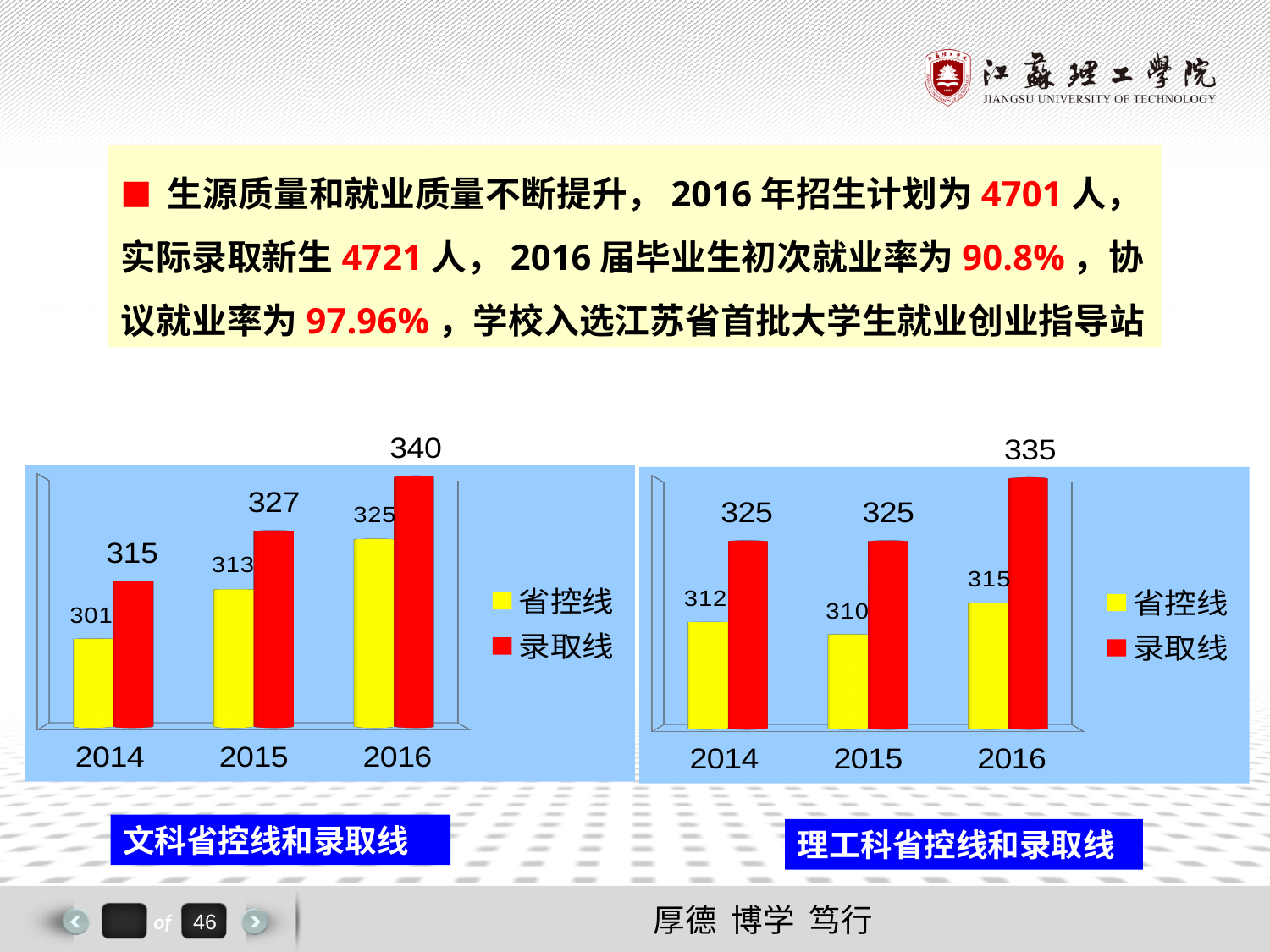
In the 理工科省控线和录取线 chart (right), what is the 省控线 value for 2015? 310 In the 文科省控线和录取线 chart (left), what is the difference between the 录取线 and the 省控线 in 2015? 14 In the 文科省控线和录取线 chart (left), which year has the highest 录取线? 2016 In the 理工科省控线和录取线 chart (right), which year has the lowest 省控线? 2015 In the 理工科省控线和录取线 chart (right), what is the 录取线 value for 2016? 335 In the 理工科省控线和录取线 chart (right), what is the difference between the 录取线 in 2016 and the 录取线 in 2015? 10 In the 文科省控线和录取线 chart (left), which is larger: the 省控线 in 2016 or the 录取线 in 2014? 省控线 in 2016 What kind of chart is the 文科省控线和录取线 chart (left)? Bar chart In the 文科省控线和录取线 chart (left), does the 省控线 rise or fall from 2014 to 2016? Rise In the 文科省控线和录取线 chart (left), what is the 省控线 value for 2014? 301 In the 文科省控线和录取线 chart (left), what is the 录取线 value for 2016? 340 How many series does the legend of the 理工科省控线和录取线 chart (right) list? 2